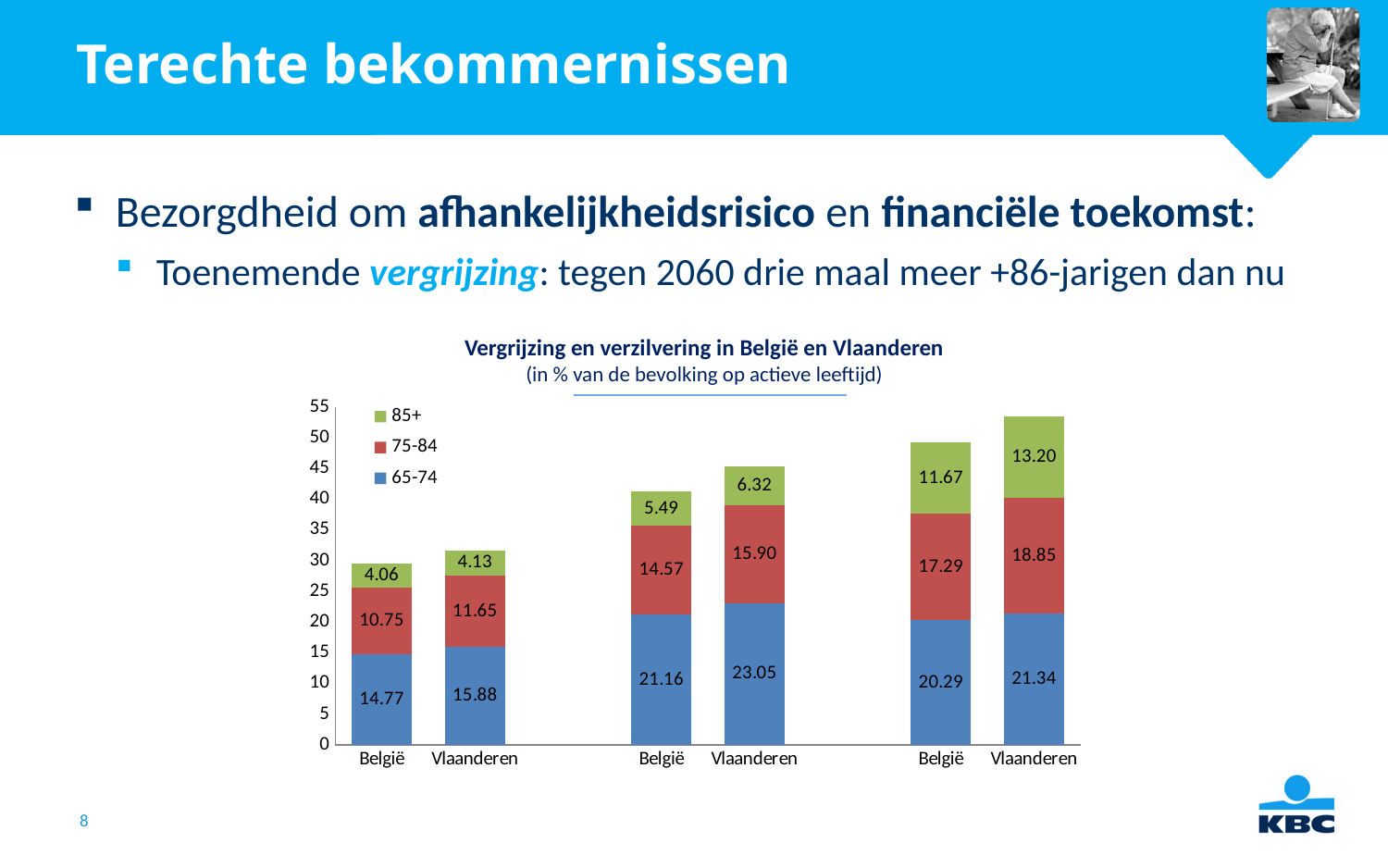
In the middle group of bars, what is the 75-84 value for Vlaanderen? 15.90 What is the title of the chart? Vergrijzing en verzilvering in België en Vlaanderen In the leftmost group of bars, what is the 65-74 value for België? 14.77 In the middle group, what is the difference between the 65-74 values for Vlaanderen and België? 1.89 How many series does the chart legend list? 3 What is the total of the stacked bar for België in the leftmost group? 29.58 What type of chart is shown on the slide? stacked bar chart Which stacked bar on the chart is the tallest overall? Vlaanderen in the rightmost group In the leftmost group of bars, what is the 85+ value for Vlaanderen? 4.13 In the rightmost group of bars, what is the 85+ value for België? 11.67 In the rightmost group, which has the larger 75-84 value, België or Vlaanderen? Vlaanderen What is the total of the stacked bar for Vlaanderen in the rightmost group? 53.39